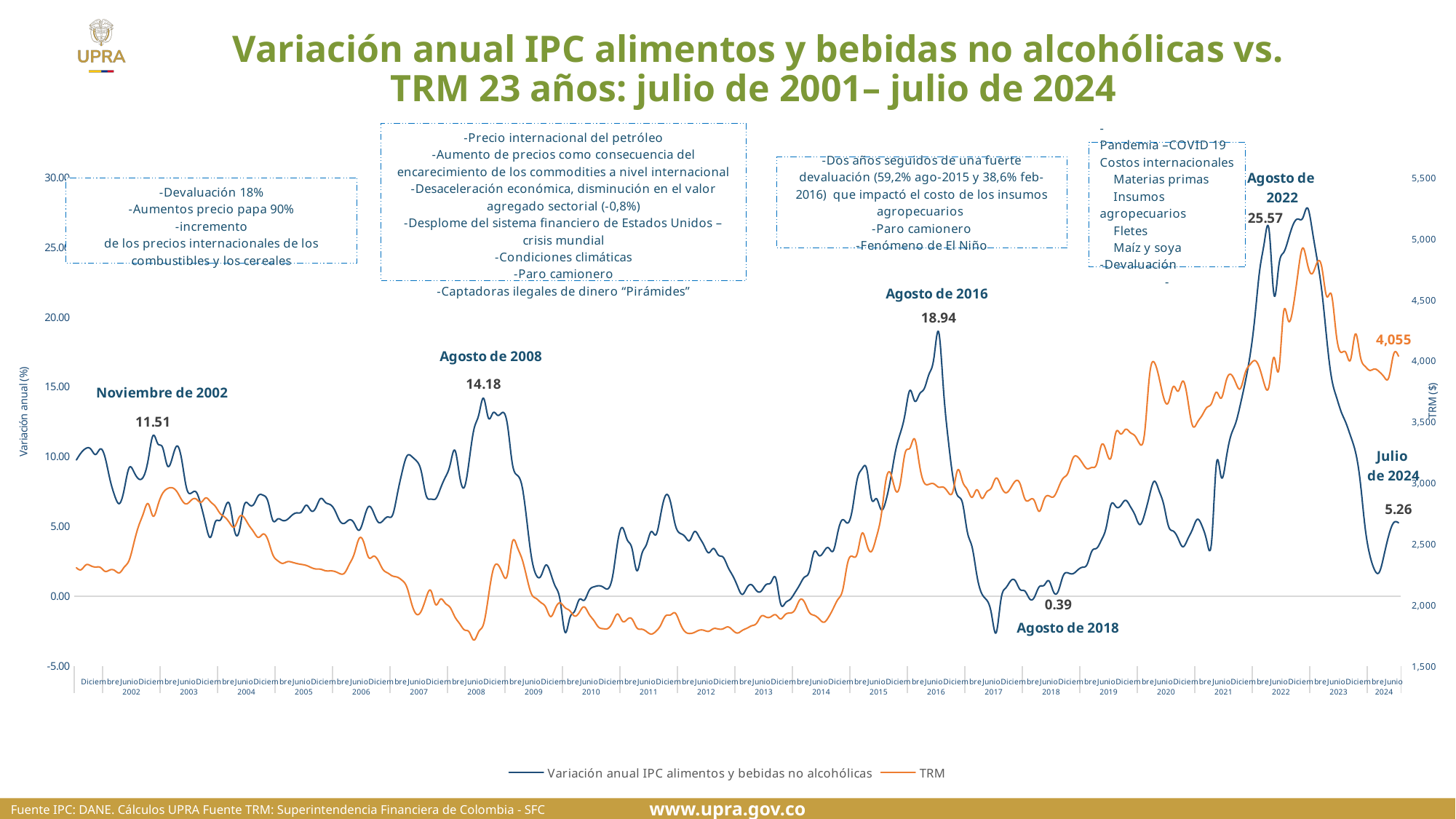
Which labelled peak of the annual IPC variation is the highest: Agosto de 2008, Agosto de 2016 or Agosto de 2022? Agosto de 2022 How many series does the legend list? 2 What kind of chart is shown on the slide? line chart What is the labelled TRM value at the end of the series (July 2024)? 4,055 What is the labelled value of the annual IPC variation in Noviembre de 2002? 11.51 What is the labelled value of the annual food and non-alcoholic beverages IPC variation in Agosto de 2022? 25.57 What is the labelled value of the annual IPC variation in Julio de 2024? 5.26 Which series is drawn in orange according to the legend? TRM What is the labelled value of the annual IPC variation in Agosto de 2016? 18.94 What is the labelled value of the annual IPC variation in Agosto de 2018? 0.39 What is the labelled value of the annual IPC variation in Agosto de 2008? 14.18 What is the difference between the labelled IPC variation values for Agosto de 2022 and Agosto de 2016? 6.63